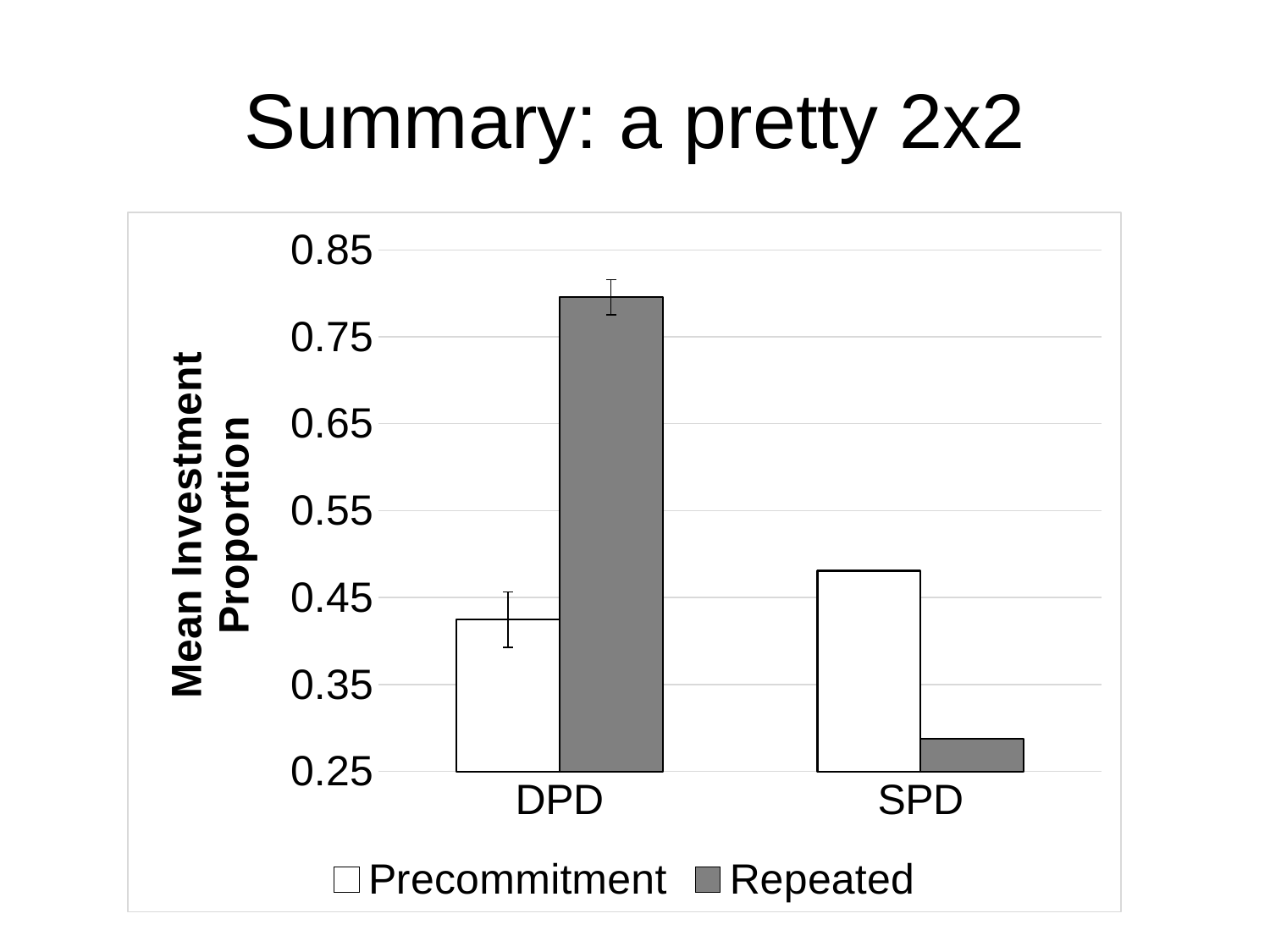
What kind of chart is shown on the slide? bar chart For DPD, which is larger: Precommitment or Repeated? Repeated Is the Precommitment value for DPD greater or less than 0.55? less How many categories are shown on the x axis? 2 How many series does the legend list? 2 For SPD, which is larger: Precommitment or Repeated? Precommitment Is the Repeated value for SPD greater or less than 0.35? less What is the title of the y axis? Mean Investment Proportion Is the Precommitment value for SPD greater or less than 0.45? greater Which bar is the tallest in the chart? Repeated for DPD Which bar is the shortest in the chart? Repeated for SPD